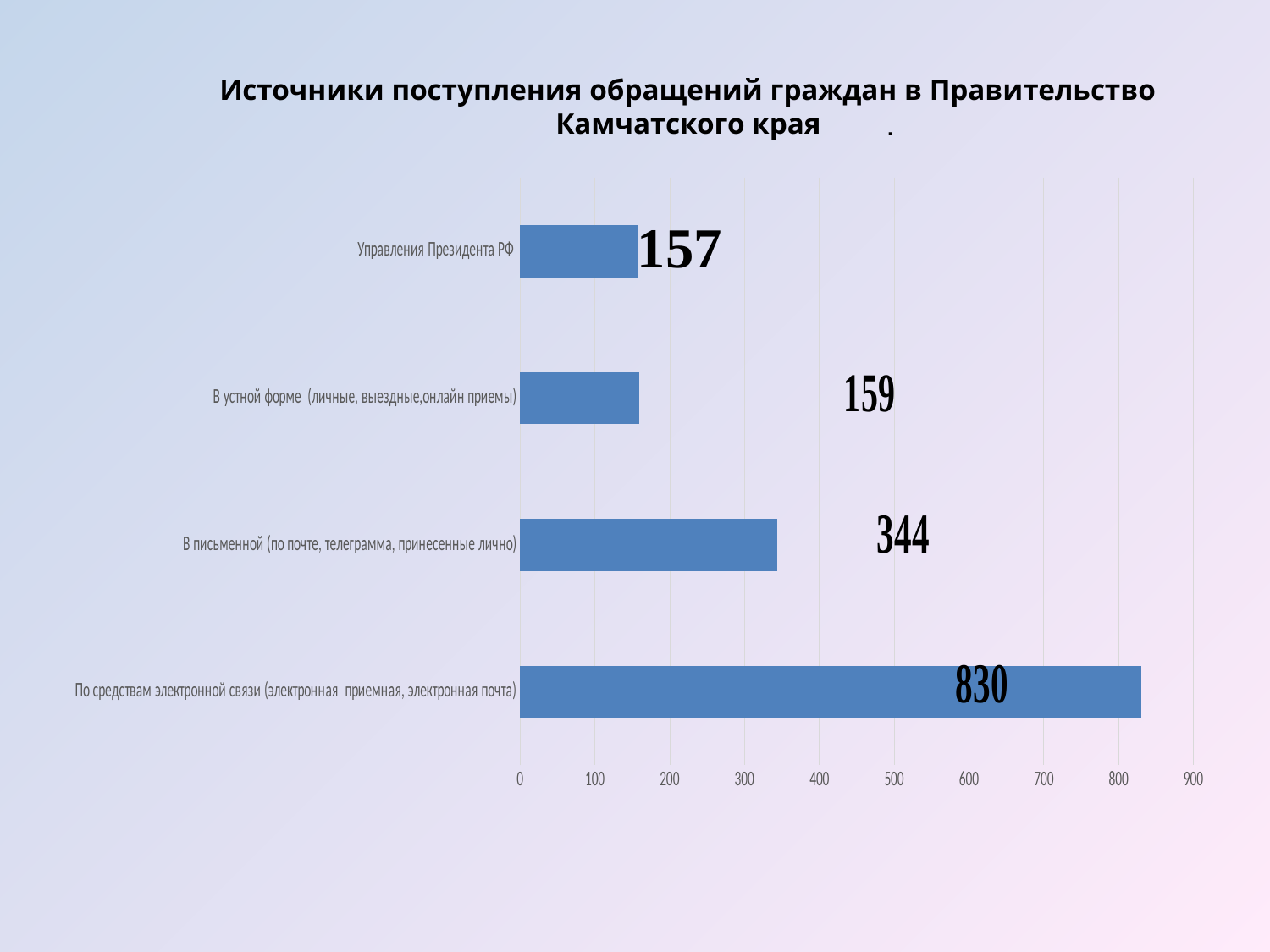
What is the difference between the values for «В письменной» and «В устной форме»? 185 Which category has the highest value? По средствам электронной связи (электронная приемная, электронная почта) What kind of chart is shown on the slide? bar chart What is the value for «В устной форме (личные, выездные, онлайн приемы)»? 159 What is the value for «В письменной (по почте, телеграмма, принесенные лично)»? 344 What is the value for «Управления Президента РФ»? 157 Which is larger: the value for «В письменной» or the value for «Управления Президента РФ»? В письменной What is the value for «По средствам электронной связи (электронная приемная, электронная почта)»? 830 How many categories are shown in the chart? 4 Is the value for «В письменной (по почте, телеграмма, принесенные лично)» greater or less than 300? greater Which category has the lowest value? Управления Президента РФ What is the difference between the values for «По средствам электронной связи» and «В письменной»? 486